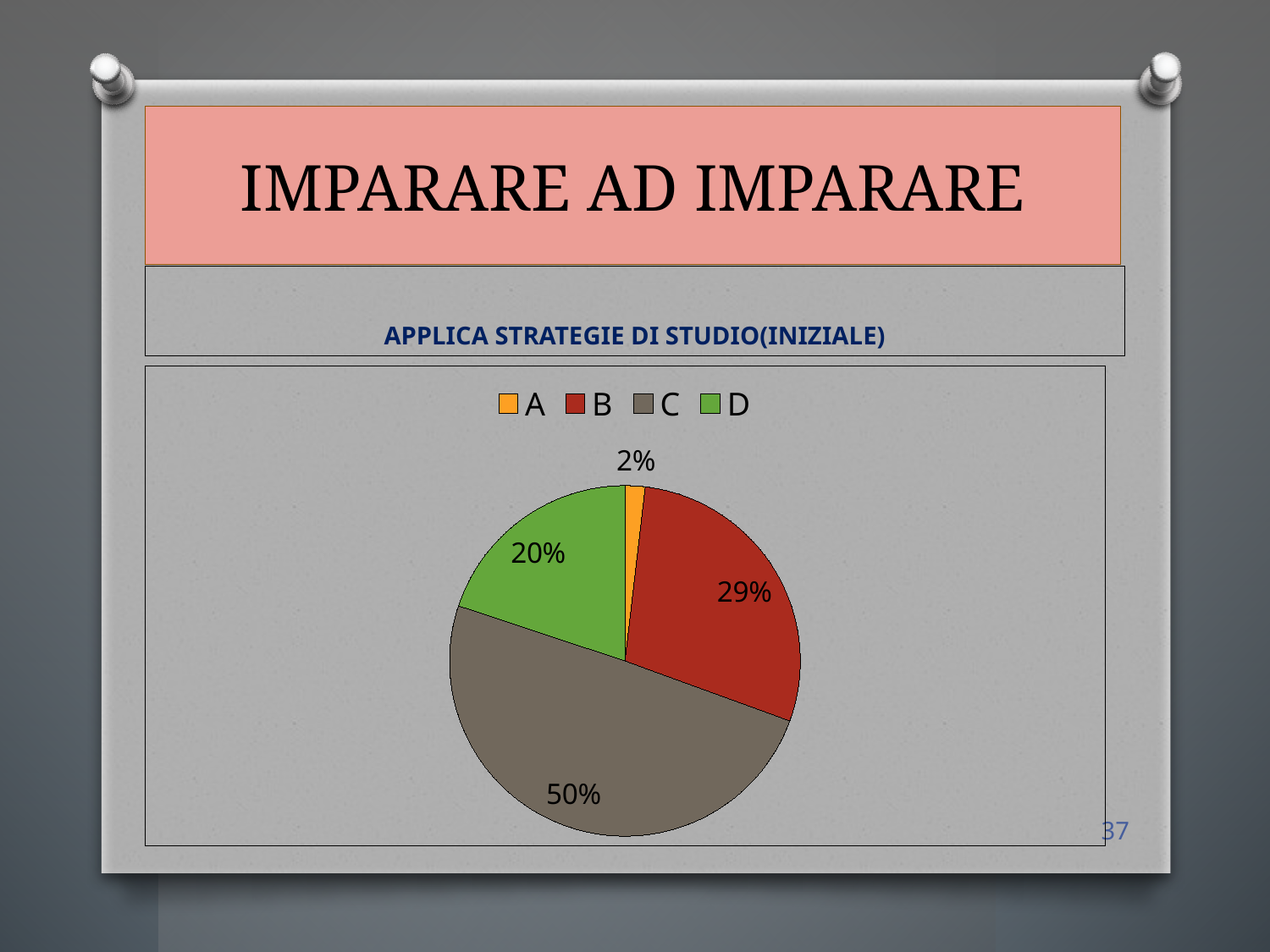
What share of the pie does category A have? 2% What is the title of the chart? APPLICA STRATEGIE DI STUDIO(INIZIALE) Which category has the smallest slice? A What share of the pie does category B have? 29% How many categories does the legend list? 4 What type of chart is shown on the slide? pie chart What is the difference between the shares of C and B? 21% What colour is the slice for category D? green What share of the pie does category D have? 20% Which is larger, the share for B or the share for D? B Which category has the largest slice? C